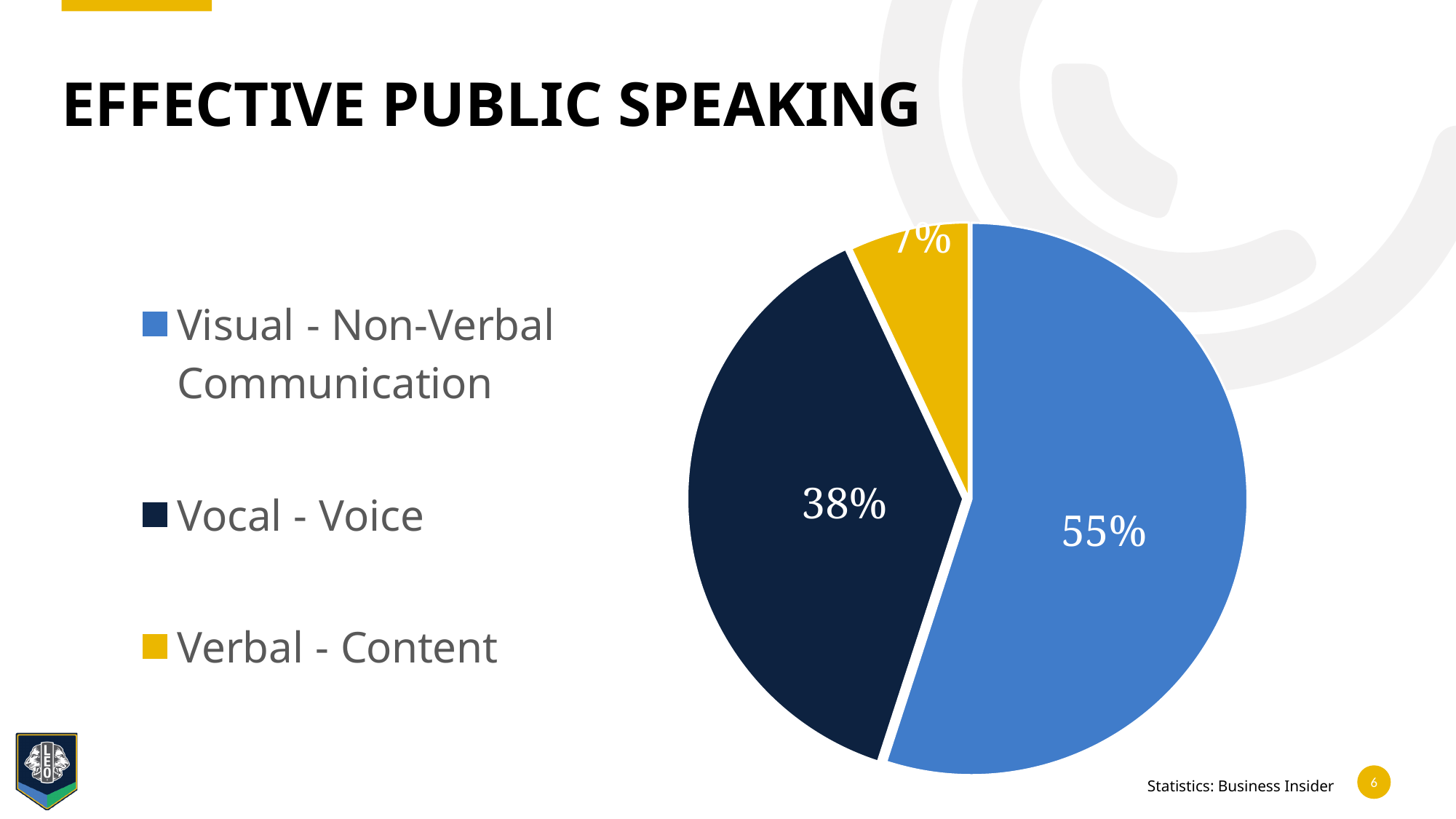
What share of the pie is Visual - Non-Verbal Communication? 55% What share of the pie is Vocal - Voice? 38% How many categories does the pie chart show? 3 What colour is the slice for Verbal - Content? Yellow What is the difference in percentage points between Vocal - Voice and Verbal - Content? 31 What kind of chart is shown on the slide? Pie chart What is the title of the slide containing the chart? EFFECTIVE PUBLIC SPEAKING Which category has the smallest slice of the pie? Verbal - Content What is the difference in percentage points between Visual - Non-Verbal Communication and Vocal - Voice? 17 Which category has the largest slice of the pie? Visual - Non-Verbal Communication Which is larger, the share for Vocal - Voice or the share for Verbal - Content? Vocal - Voice What share of the pie is Verbal - Content? 7%